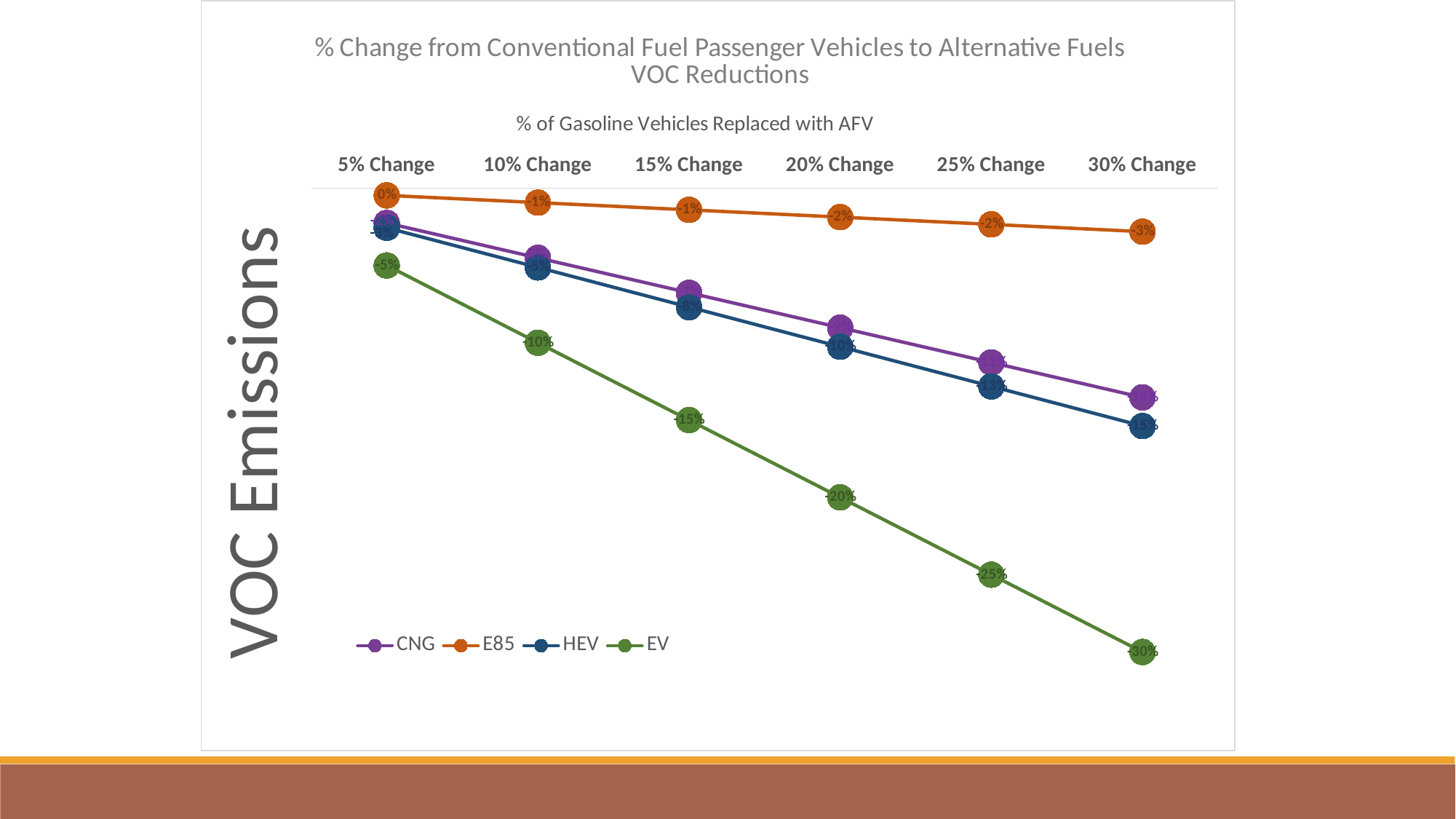
What is the value for EV at 15% Change? -15% What is the value for E85 at 5% Change? 0% What kind of chart is shown on the slide? line chart How many series does the legend list? 4 What is the value for EV at 30% Change? -30% Which series has the lowest value at 30% Change? EV How many categories are shown along the x axis? 6 What is the difference between the EV value at 30% Change and the EV value at 5% Change? 25% Which series has the highest value at 30% Change? E85 What is the value for E85 at 30% Change? -3% What is the value for HEV at 30% Change? -15% Do the EV values rise or fall as the percentage of gasoline vehicles replaced increases? fall